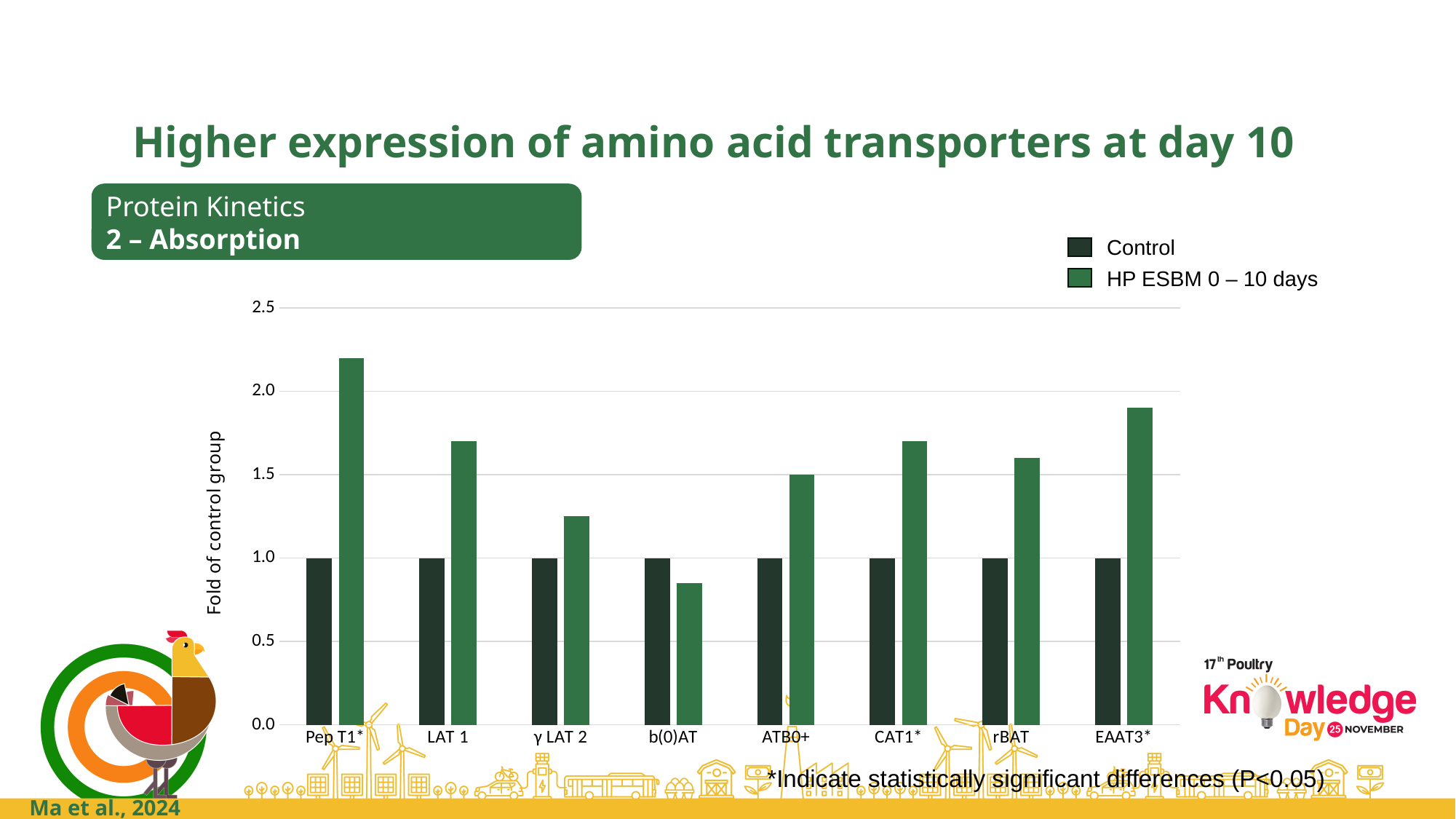
Which transporter has the lowest HP ESBM 0 – 10 days value? b(0)AT What is the label on the y axis of the chart? Fold of control group Is the HP ESBM 0 – 10 days value for Pep T1* greater or less than 2.0? greater Is the HP ESBM 0 – 10 days value for b(0)AT greater or less than 1.0? less Is the HP ESBM 0 – 10 days value for EAAT3* greater or less than 1.5? greater What is the HP ESBM 0 – 10 days value for ATB0+? 1.5 What kind of chart is shown on the slide? bar chart Which is larger, the HP ESBM 0 – 10 days value for γ LAT 2 or for rBAT? rBAT How many amino acid transporter categories are shown on the x axis? 8 What is the Control value for LAT 1? 1.0 Which transporter has the highest HP ESBM 0 – 10 days value? Pep T1* How many series does the legend list? 2